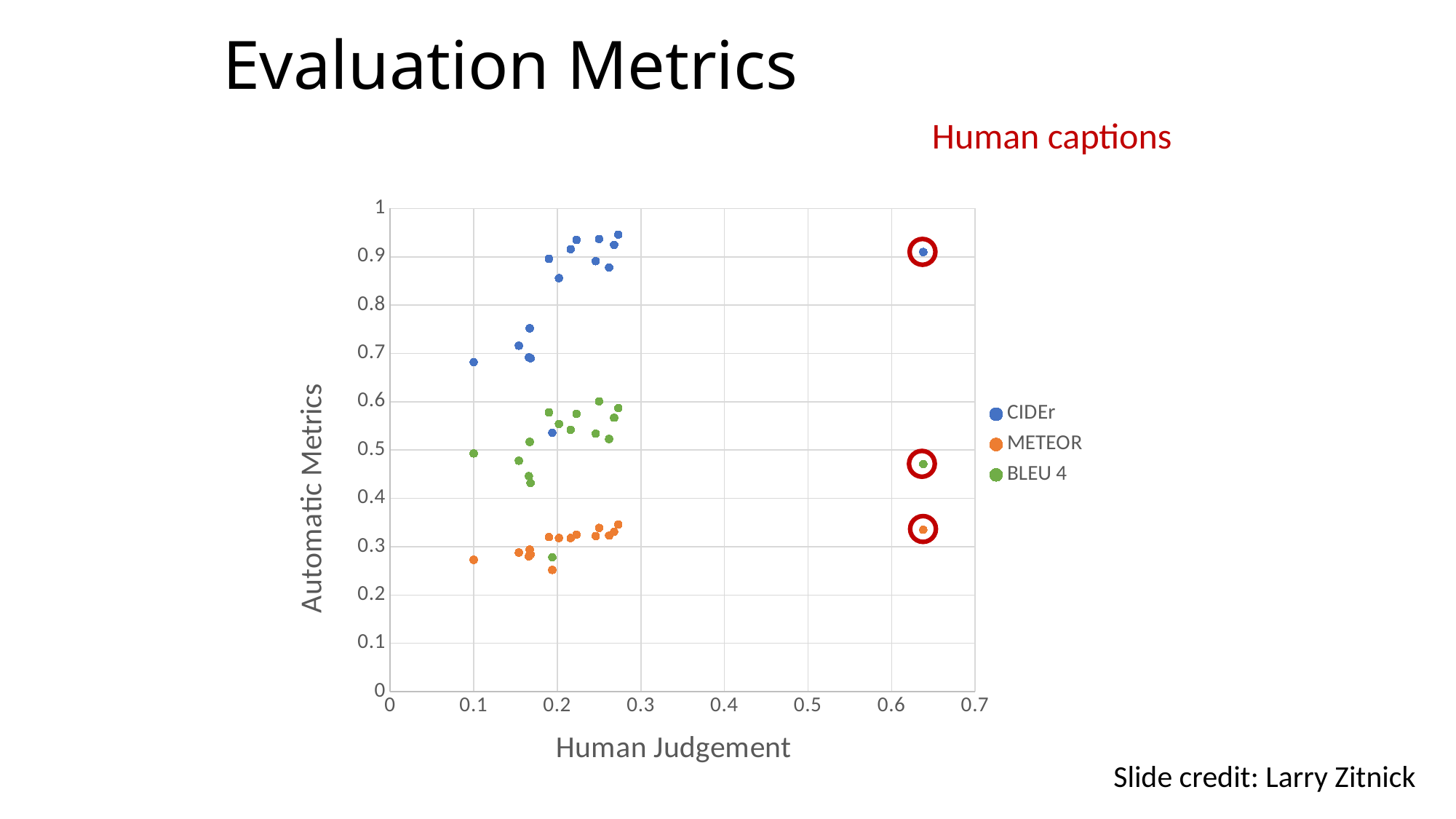
Which series has higher Automatic Metrics values, BLEU 4 or METEOR? BLEU 4 Is the Automatic Metrics value of the circled METEOR point for human captions greater or less than 0.3? greater What is the label of the x axis of the chart? Human Judgement How many series does the chart legend list? 3 Is the Automatic Metrics value of the circled CIDEr point for human captions greater or less than 0.8? greater What are the three series listed in the chart legend? CIDEr, METEOR, BLEU 4 Is the Automatic Metrics value of the circled BLEU 4 point for human captions greater or less than 0.5? less Do the CIDEr values generally rise or fall as Human Judgement increases? rise Which series has the highest Automatic Metrics values on the chart? CIDEr Which series has the lowest Automatic Metrics values on the chart? METEOR What kind of chart is shown on the slide? scatter chart